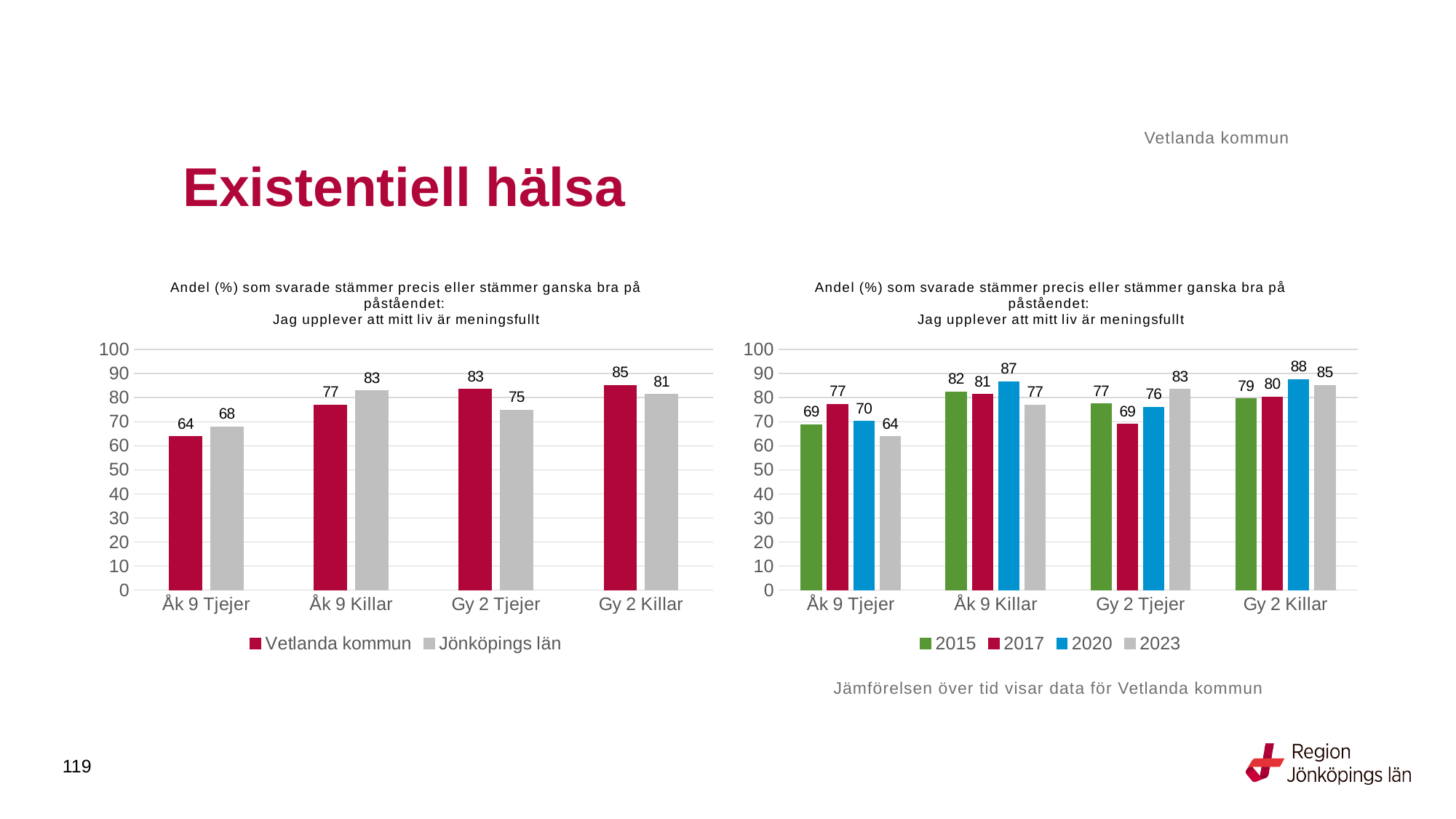
In the right chart, what is the value for 2017 for Gy 2 Tjejer? 69 In the right chart, what is the difference between 2020 and 2023 for Åk 9 Killar? 10 How many series does the legend of the left chart list? 2 In the left chart, which is larger for Gy 2 Tjejer: Vetlanda kommun or Jönköpings län? Vetlanda kommun In the right chart, which year has the lowest value for Åk 9 Tjejer? 2023 In the left chart, what is the value for Jönköpings län for Gy 2 Tjejer? 75 In the left chart, what is the value for Vetlanda kommun for Åk 9 Tjejer? 64 How many series does the legend of the right chart list? 4 In the left chart, what is the difference between Jönköpings län and Vetlanda kommun for Åk 9 Killar? 6 What type of chart is the right chart? Bar chart In the left chart, which category has the highest value for Vetlanda kommun? Gy 2 Killar In the right chart, what is the value for 2020 for Gy 2 Killar? 88